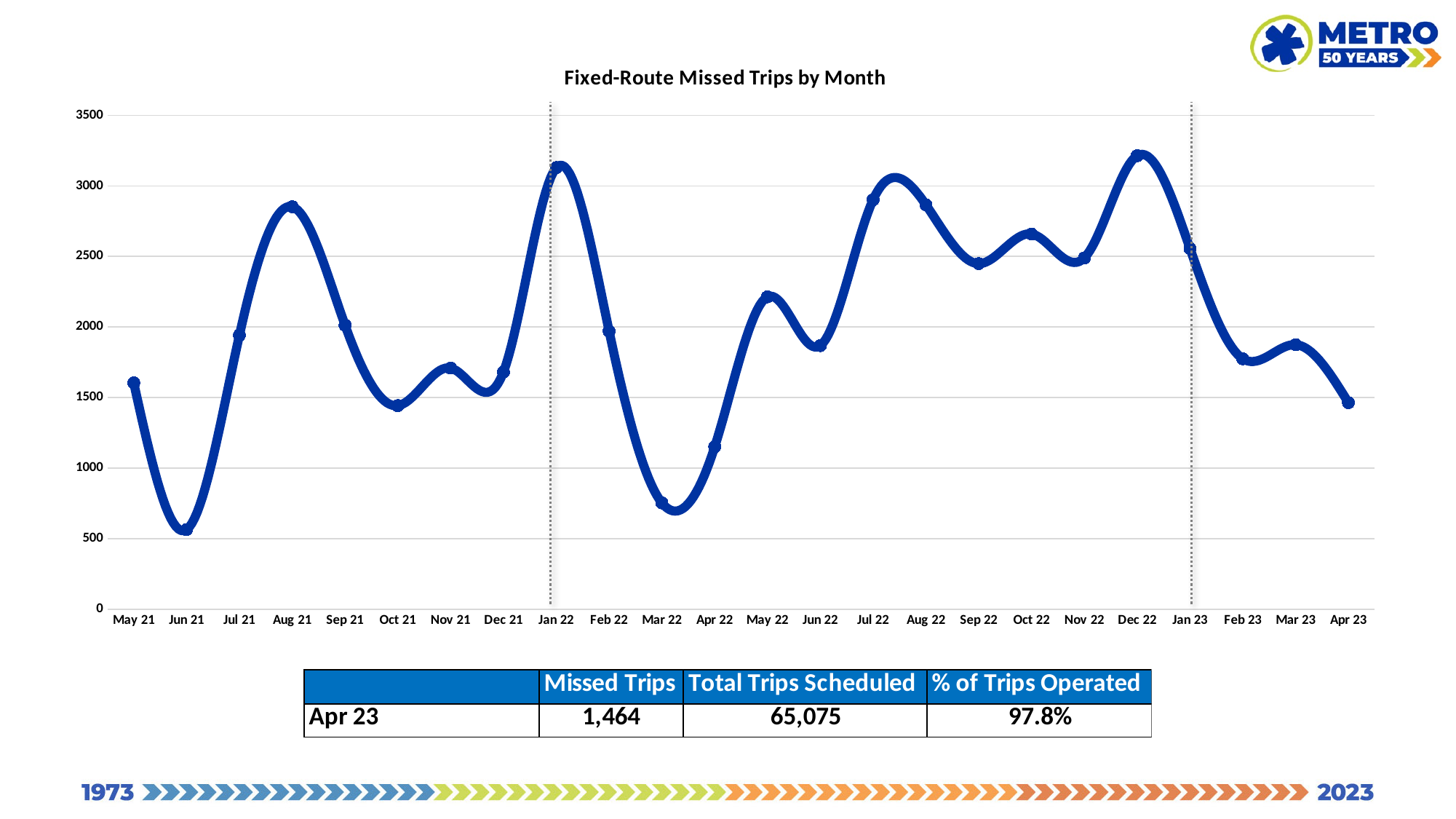
How many missed trips are shown for Apr 23? 1,464 Do missed trips rise or fall from Dec 22 to Apr 23? fall Which month has more missed trips, Mar 22 or Apr 22? Apr 22 Is the value for Jun 21 greater or less than 1000? less Is the value for Mar 22 greater or less than 1000? less What kind of chart is shown on the slide? line chart Which month has the lowest number of missed trips? Jun 21 Is the value for Dec 22 greater or less than 3000? greater How many months are plotted on the x axis of the chart? 24 Which month has more missed trips, Aug 21 or Sep 21? Aug 21 What is the title of the chart? Fixed-Route Missed Trips by Month